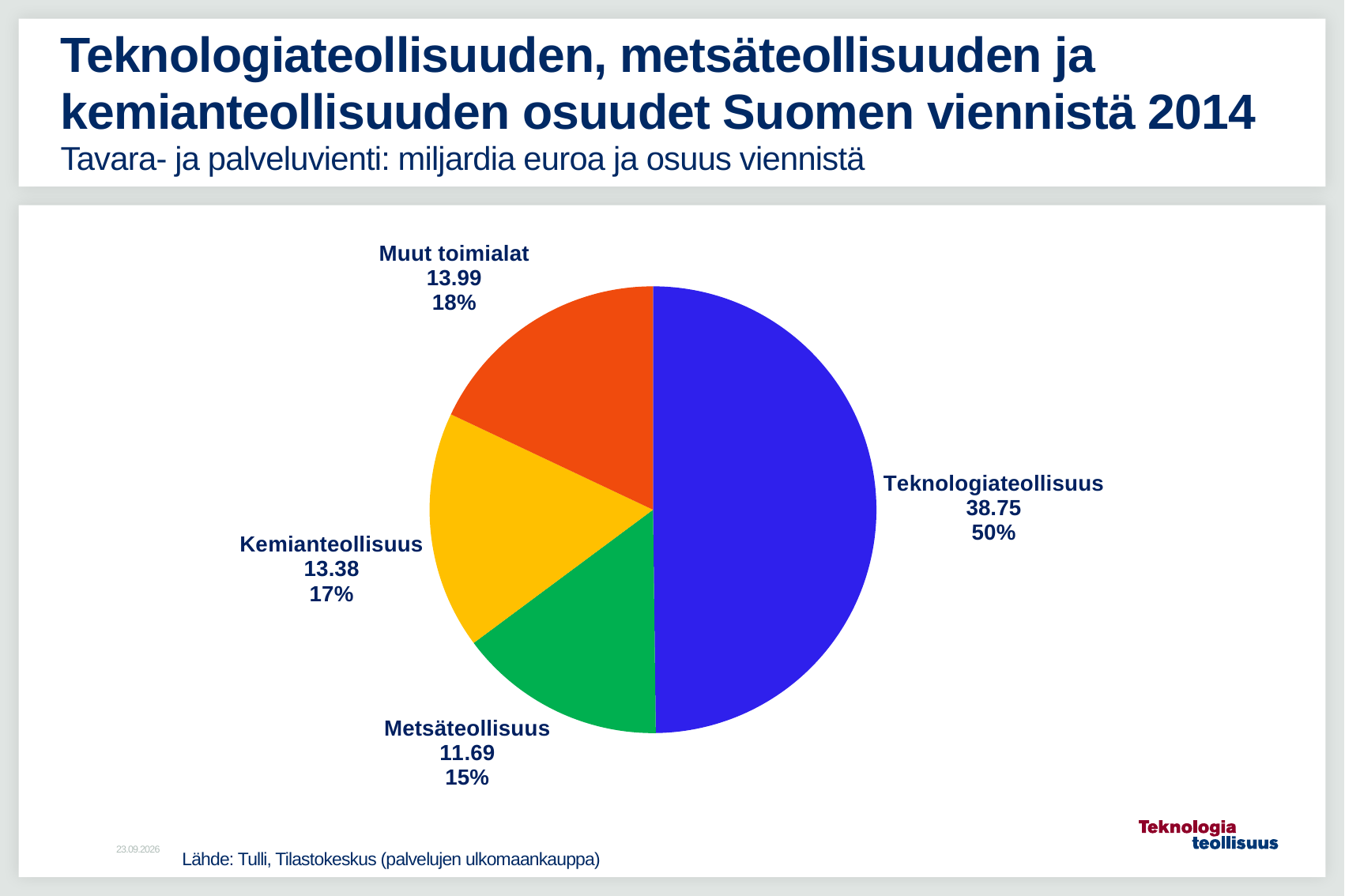
What is the value shown for Kemianteollisuus? 13.38 What type of chart is shown on the slide? Pie chart What share of the pie does Metsäteollisuus have? 15% What is the difference between the values for Teknologiateollisuus and Metsäteollisuus? 27.06 Which has a larger value, Kemianteollisuus or Metsäteollisuus? Kemianteollisuus What share of the pie does Muut toimialat have? 18% Which slice of the pie is the largest? Teknologiateollisuus How many slices does the pie chart have? 4 What is the value shown for Teknologiateollisuus? 38.75 What is the difference between the values for Muut toimialat and Kemianteollisuus? 0.61 Which slice of the pie is the smallest? Metsäteollisuus What colour is the Teknologiateollisuus slice? Blue